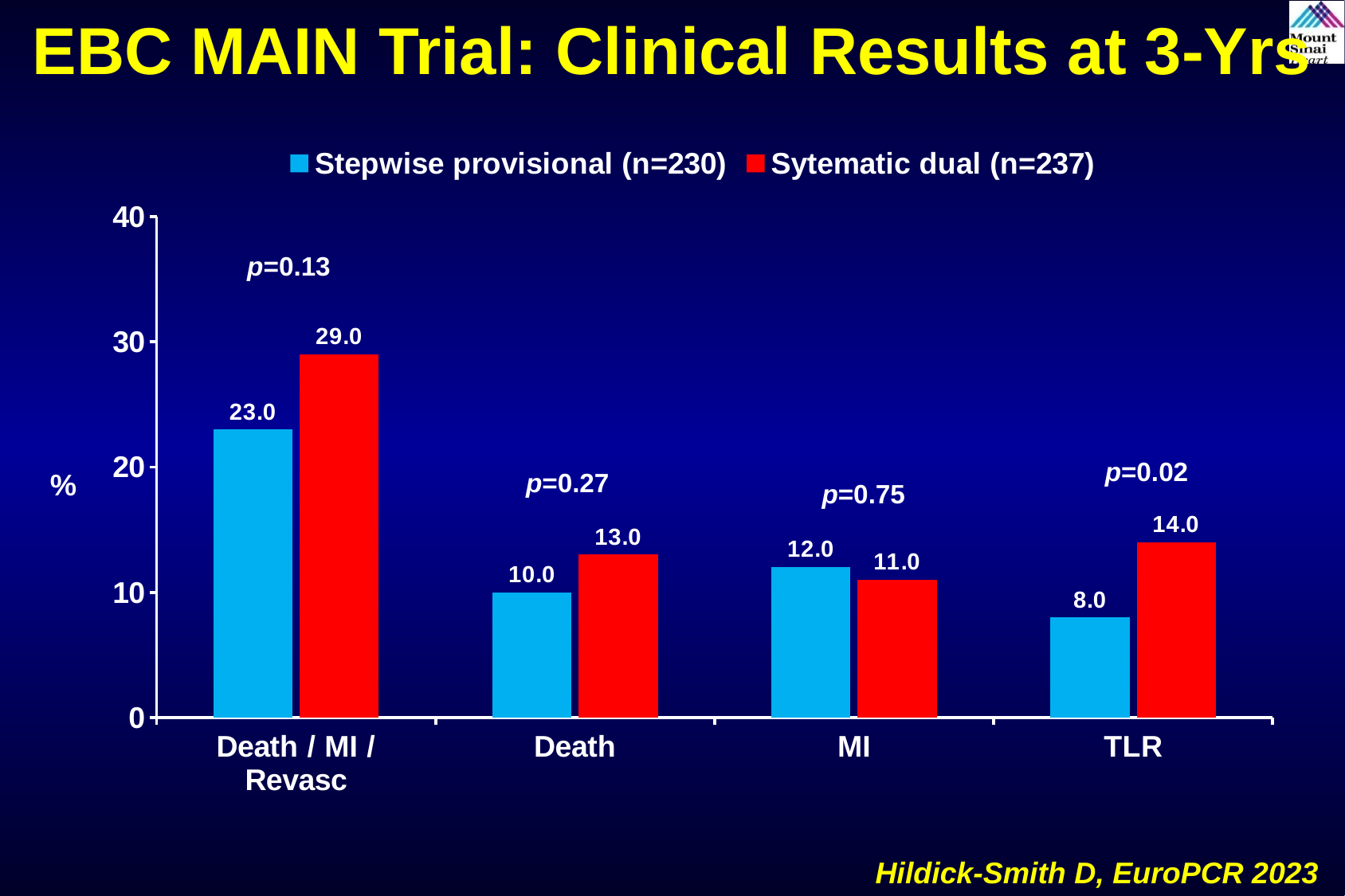
How many series does the legend list? 2 Is the value for Sytematic dual (n=237) in the Death / MI / Revasc category greater or less than 30? less Which category has the lowest value for Stepwise provisional (n=230)? TLR What is the value for Sytematic dual (n=237) in the Death category? 13.0 What is the value for Sytematic dual (n=237) in the TLR category? 14.0 Which category has the highest value for Sytematic dual (n=237)? Death / MI / Revasc What is the value for Stepwise provisional (n=230) in the Death / MI / Revasc category? 23.0 In the MI category, which series has the larger value? Stepwise provisional (n=230) What is the difference between the Sytematic dual (n=237) and Stepwise provisional (n=230) values in the TLR category? 6.0 How many categories are shown on the x axis? 4 What is the difference between the Sytematic dual (n=237) and Stepwise provisional (n=230) values in the Death / MI / Revasc category? 6.0 What kind of chart is shown on the slide? bar chart